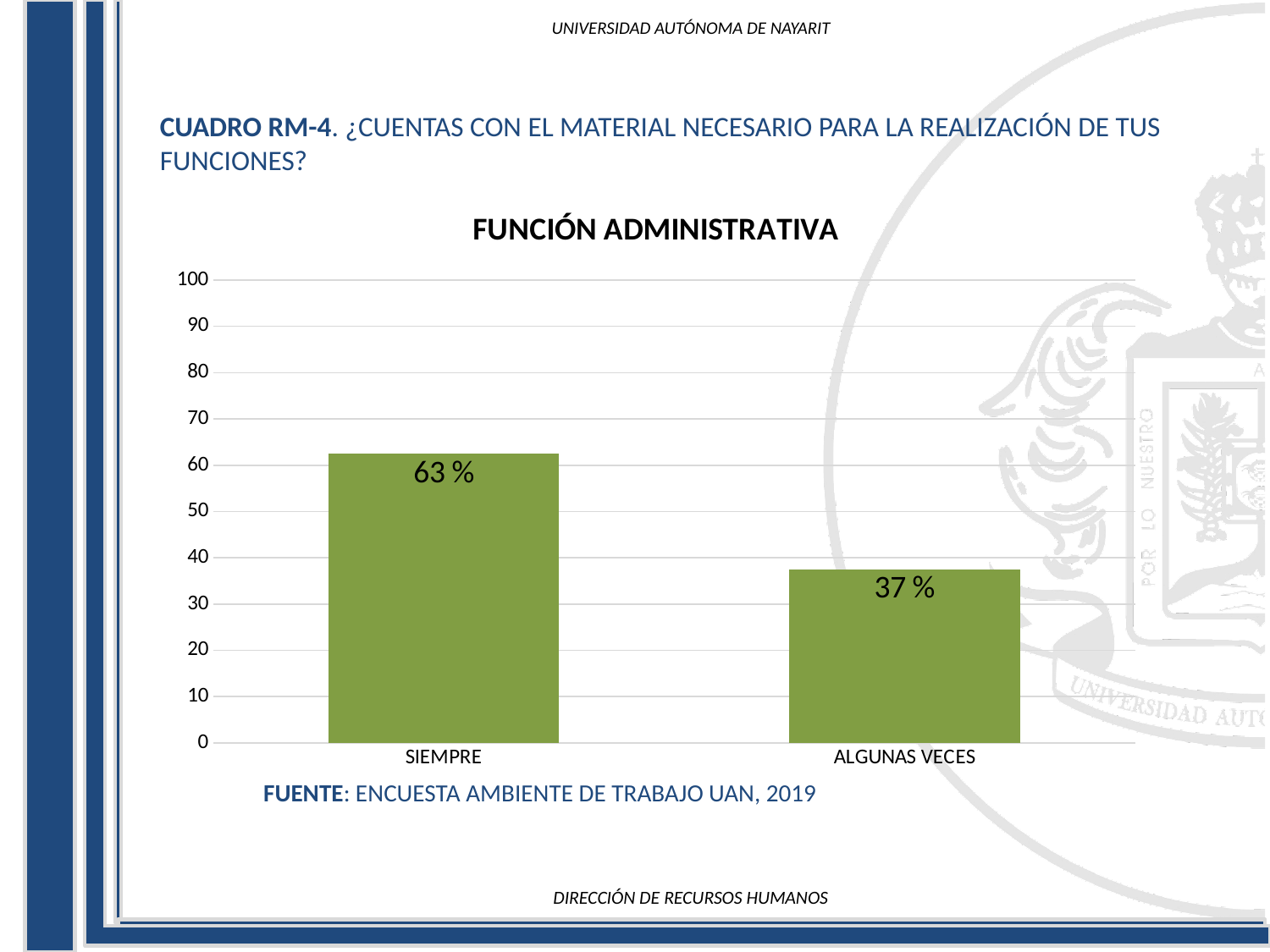
Is the value for ALGUNAS VECES greater or less than 40? less Is the value for SIEMPRE greater or less than 60? greater What is the maximum value shown on the y axis? 100 Which category has the highest value? SIEMPRE What is the value for SIEMPRE? 63 % How many categories are shown on the x axis? 2 What is the value for ALGUNAS VECES? 37 % Which category has the lowest value? ALGUNAS VECES What is the title of the chart? FUNCIÓN ADMINISTRATIVA What kind of chart is shown on the slide? bar chart What is the difference between the values for SIEMPRE and ALGUNAS VECES? 26 % Which is larger, the value for SIEMPRE or the value for ALGUNAS VECES? SIEMPRE